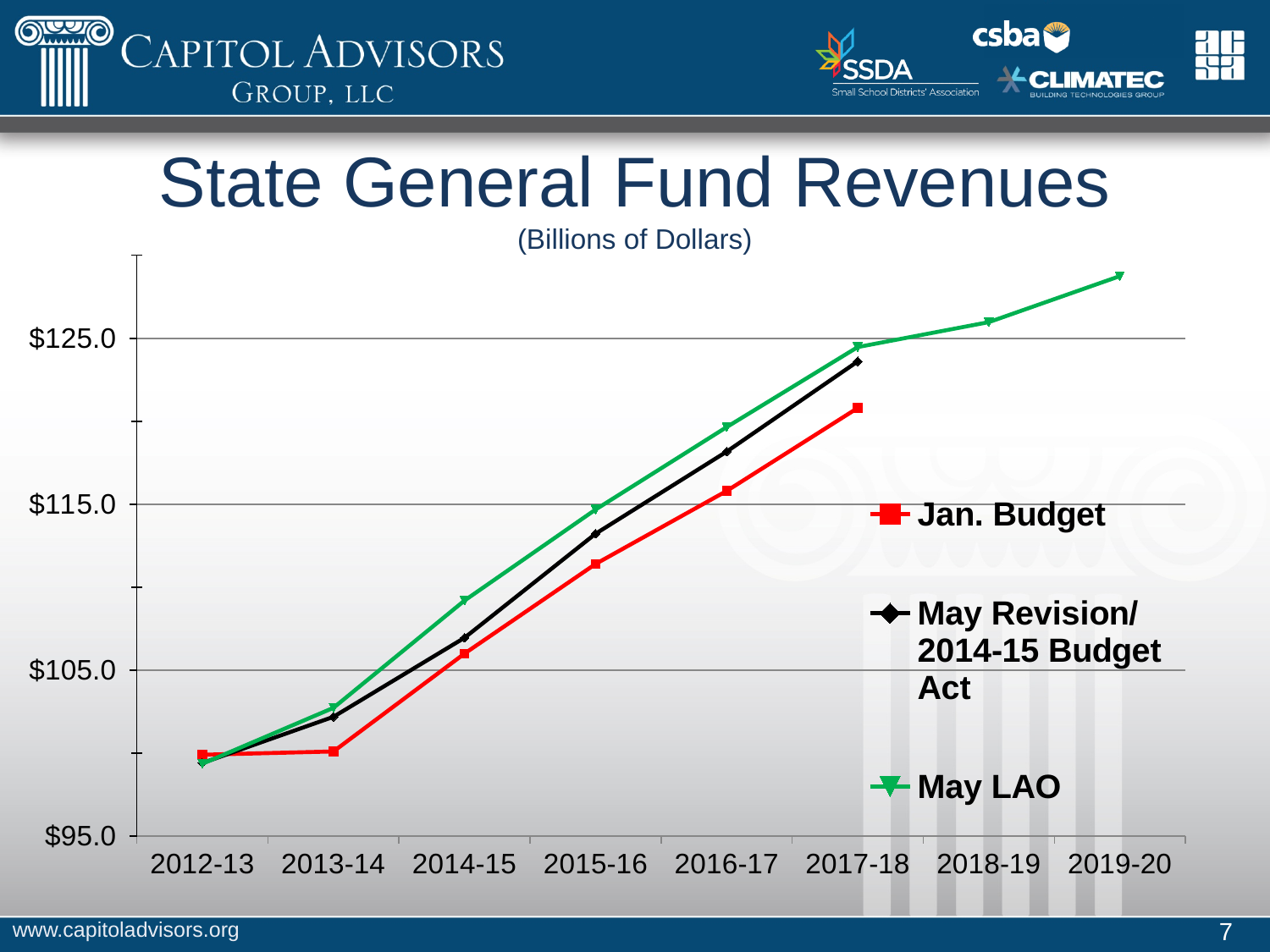
In 2017-18, which is larger: the May LAO value or the Jan. Budget value? May LAO In what units are the values on the chart expressed, according to the subtitle? Billions of Dollars What kind of chart is shown on the slide? line chart Is the Jan. Budget value for 2013-14 greater or less than $105.0? less Is the May LAO value for 2019-20 greater or less than $125.0? greater Is the May Revision/2014-15 Budget Act value for 2016-17 greater or less than $115.0? greater Do the May LAO values rise or fall from 2012-13 to 2019-20? rise Which series has the highest value in 2016-17? May LAO How many fiscal years are shown on the x axis? 8 How many series does the legend list? 3